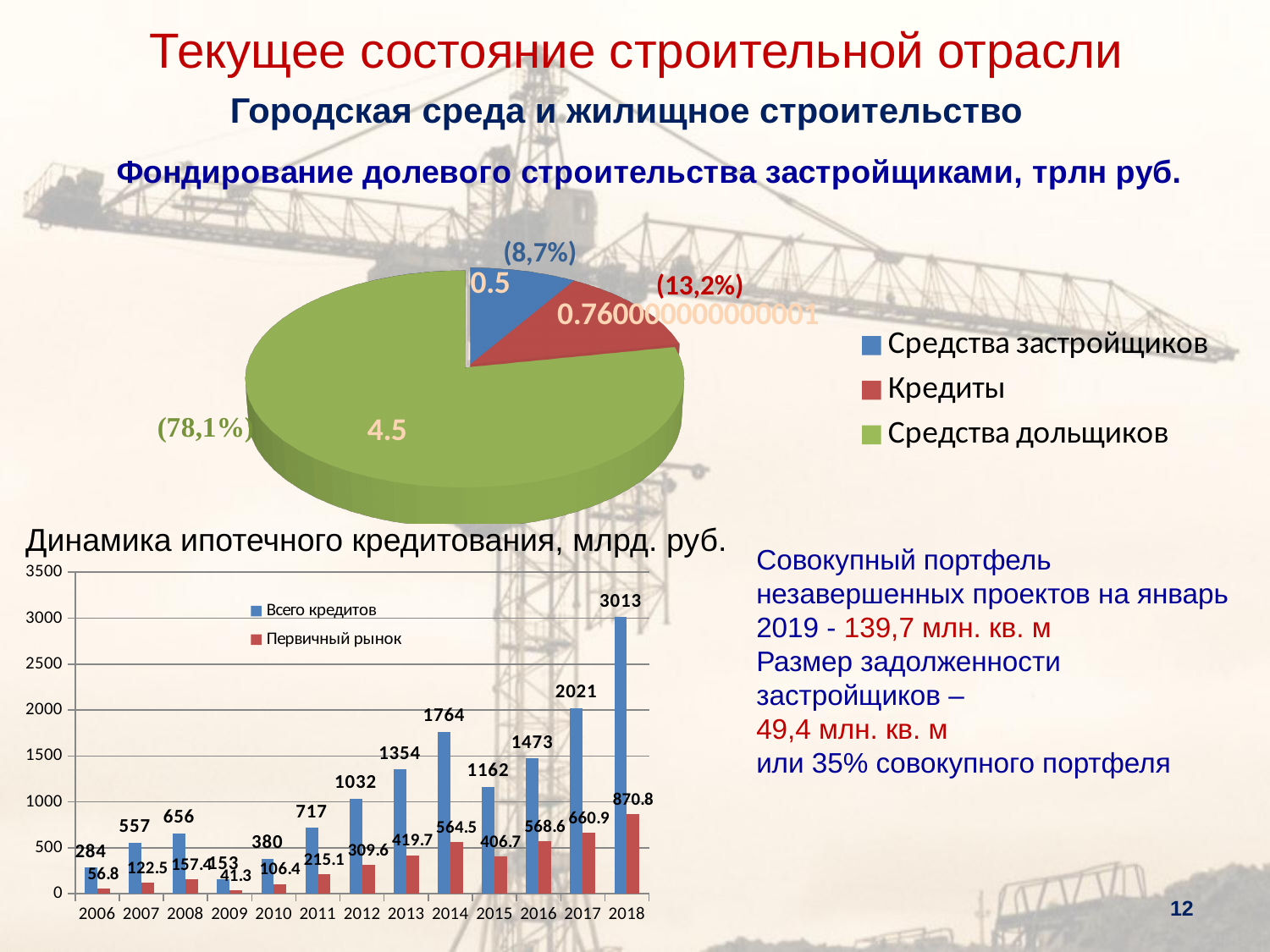
In the bar chart 'Динамика ипотечного кредитования, млрд. руб.', what is the value of Всего кредитов for 2018? 3013 In the pie chart 'Фондирование долевого строительства застройщиками, трлн руб.', what value is shown for Средства дольщиков? 4.5 In the pie chart 'Фондирование долевого строительства застройщиками, трлн руб.', how many categories does the legend list? 3 In the bar chart 'Динамика ипотечного кредитования, млрд. руб.', what is the difference between Всего кредитов in 2017 and in 2016? 548 In the bar chart 'Динамика ипотечного кредитования, млрд. руб.', which year has the highest value of Всего кредитов? 2018 In the bar chart 'Динамика ипотечного кредитования, млрд. руб.', what is the value of Первичный рынок for 2014? 564.5 What type of chart is 'Динамика ипотечного кредитования, млрд. руб.'? bar chart In the bar chart 'Динамика ипотечного кредитования, млрд. руб.', which year has the lowest value of Первичный рынок? 2009 In the pie chart 'Фондирование долевого строительства застройщиками, трлн руб.', what percentage share is shown for Кредиты? 13,2% In the bar chart 'Динамика ипотечного кредитования, млрд. руб.', how many years are shown on the x axis? 13 In the pie chart 'Фондирование долевого строительства застройщиками, трлн руб.', which category has the largest slice? Средства дольщиков In the bar chart 'Динамика ипотечного кредитования, млрд. руб.', which is larger: Всего кредитов in 2014 or in 2015? 2014